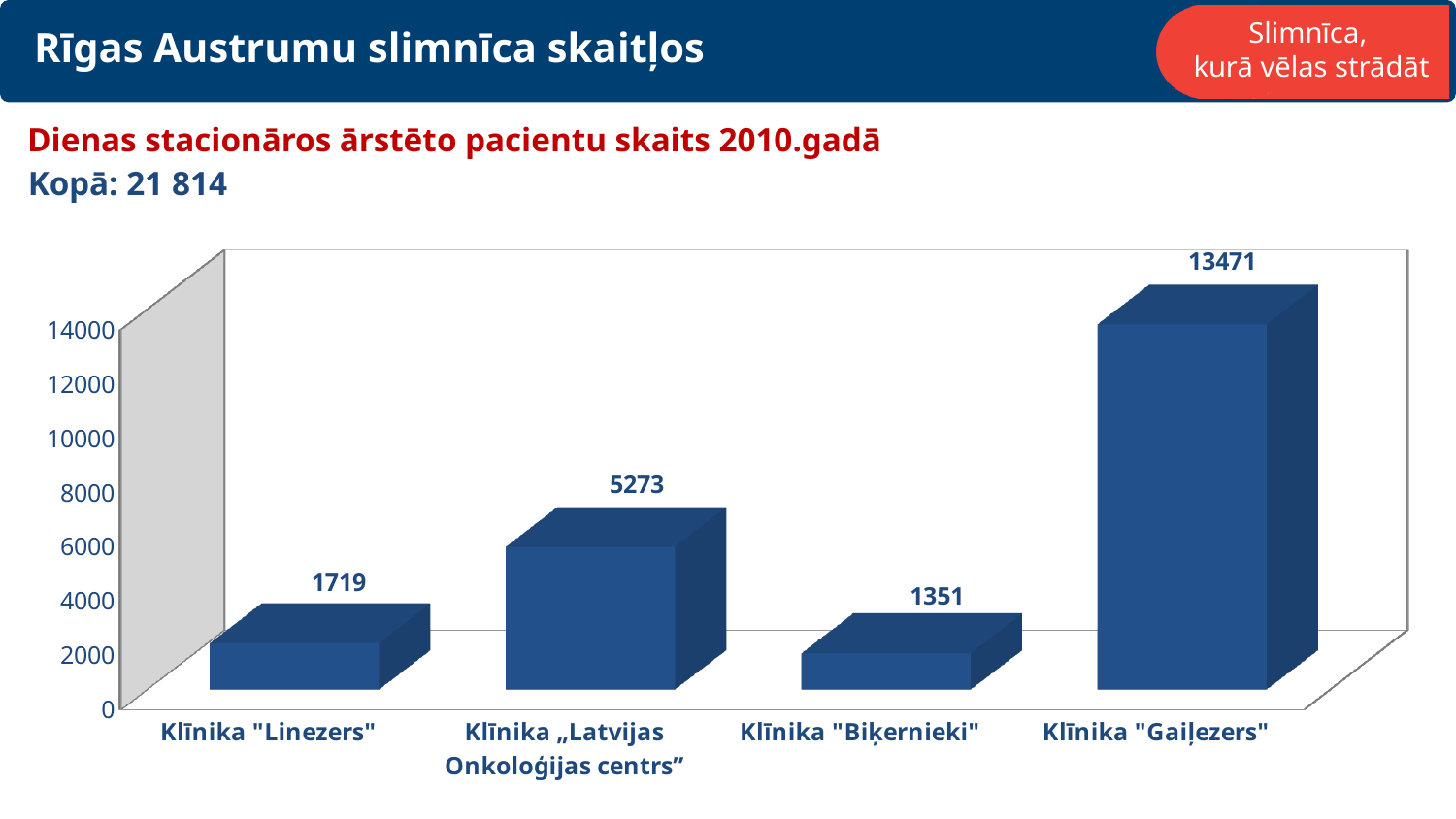
Which clinic has the lowest number of day-hospital patients? Klīnika "Biķernieki" What is the difference between the values for Klīnika "Linezers" and Klīnika "Biķernieki"? 368 What kind of chart is shown on the slide? bar chart Which clinic has the highest number of day-hospital patients? Klīnika "Gaiļezers" Is the value for Klīnika "Gaiļezers" greater or less than 12000? greater What is the difference between the values for Klīnika "Gaiļezers" and Klīnika „Latvijas Onkoloģijas centrs”? 8198 What is the value for Klīnika "Gaiļezers"? 13471 What is the value for Klīnika "Biķernieki"? 1351 How many clinics are shown on the chart? 4 Which is larger, the value for Klīnika „Latvijas Onkoloģijas centrs” or Klīnika "Linezers"? Klīnika „Latvijas Onkoloģijas centrs” What is the value for Klīnika "Linezers"? 1719 What is the value for Klīnika „Latvijas Onkoloģijas centrs”? 5273